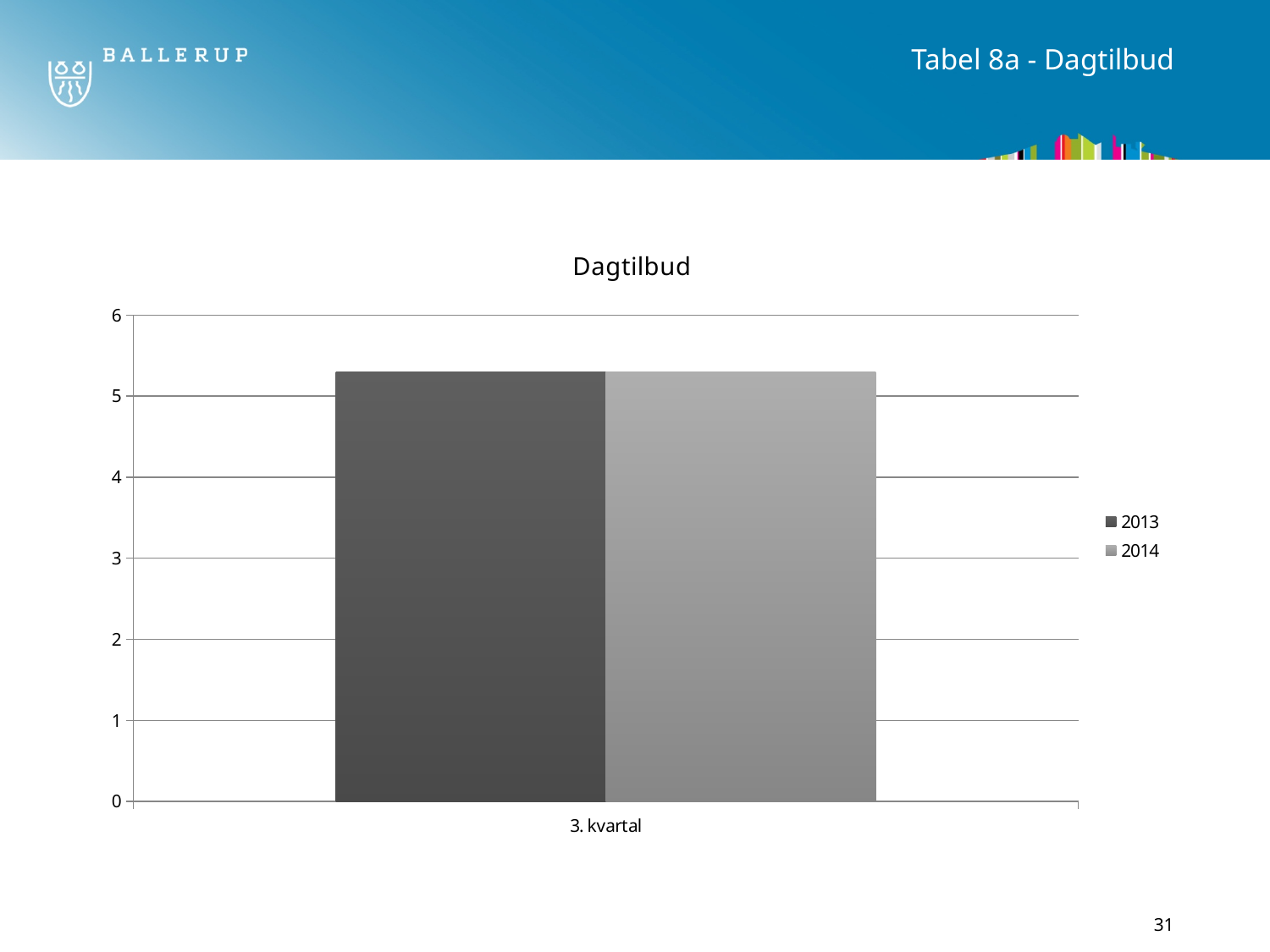
What is the title of the chart? Dagtilbud Which series are listed in the legend? 2013 and 2014 What is the highest value shown on the y axis? 6 How many series does the legend list? 2 What kind of chart is shown on the slide? bar chart How many categories are shown on the x axis? 1 Is the value for 2014 in 3. kvartal greater or less than 5? greater Is the value for 2014 in 3. kvartal greater or less than 4? greater Is the value for 2013 in 3. kvartal greater or less than 5? greater What is the category label on the x axis? 3. kvartal